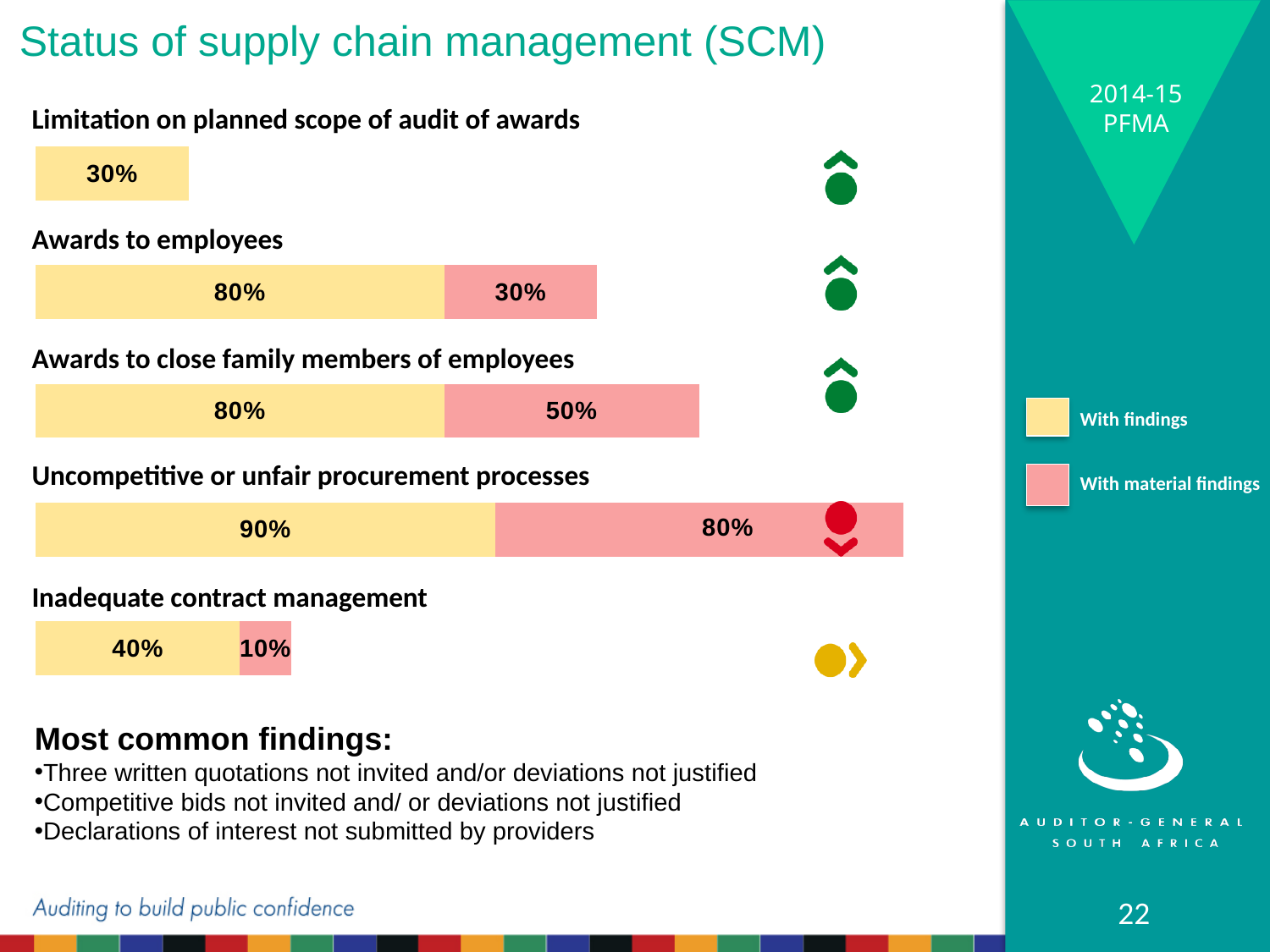
What is the 'With findings' value for Awards to employees? 80% What is the difference between the 'With findings' and 'With material findings' values for Awards to employees? 50% What kind of chart is shown on the slide? Bar chart Which category has the highest 'With findings' value? Uncompetitive or unfair procurement processes How many series does the legend list? 2 What is the 'With material findings' value for Awards to close family members of employees? 50% What is the 'With findings' value for Inadequate contract management? 40% What is the 'With findings' value for Limitation on planned scope of audit of awards? 30% How many categories are shown in the chart? 5 Which is larger: the 'With material findings' value for Awards to close family members of employees or for Awards to employees? Awards to close family members of employees Which category has the lowest 'With material findings' value among those showing one? Inadequate contract management What is the 'With material findings' value for Uncompetitive or unfair procurement processes? 80%